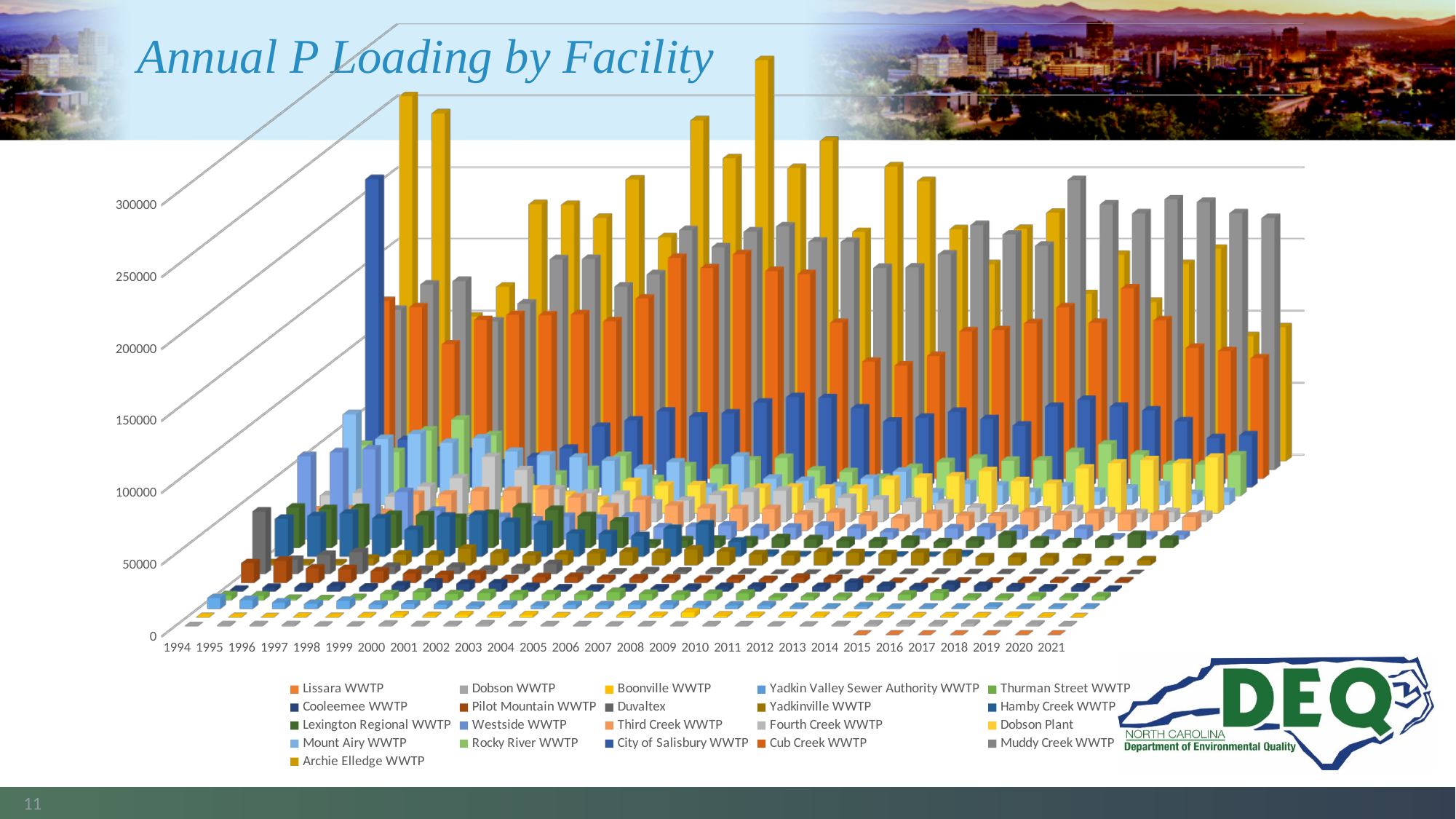
Is the value for Boonville WWTP in 2010 greater or less than 50000? less How many years are shown along the x axis of the chart? 28 How many facilities (series) does the legend list? 21 What kind of chart is shown on the slide? bar chart What is the title of the chart? Annual P Loading by Facility What is the first year shown on the x axis? 1994 Is the value for Lissara WWTP in 2021 greater or less than 50000? less